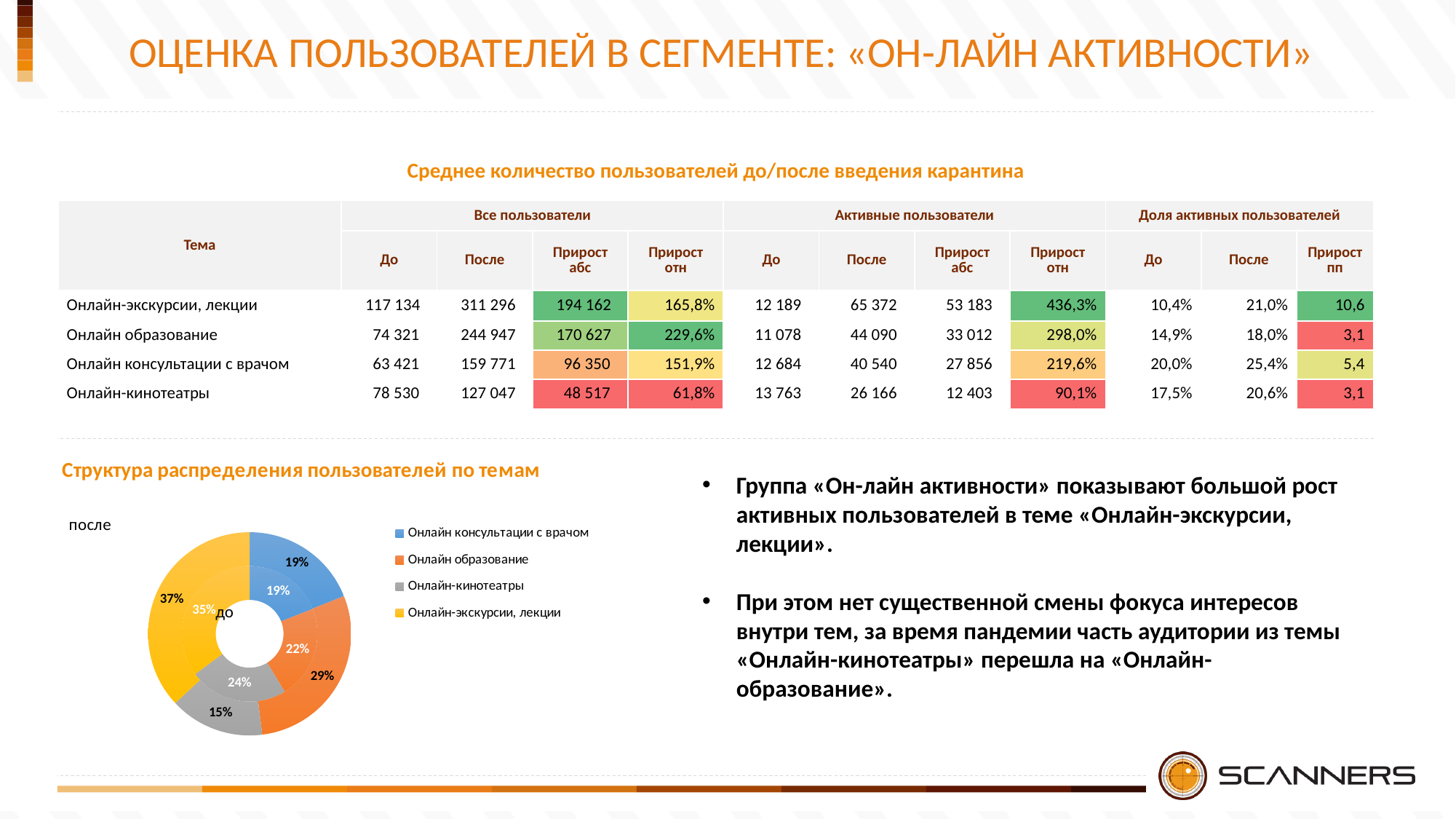
In the doughnut chart, what share does «Онлайн-кинотеатры» have in the outer ring («после»)? 15% In the doughnut chart, what share does «Онлайн-кинотеатры» have in the inner ring («до»)? 24% In the doughnut chart, what share does «Онлайн-экскурсии, лекции» have in the inner ring («до»)? 35% What kind of chart is shown under the heading «Структура распределения пользователей по темам»? Doughnut chart In the doughnut chart, which topic has the smallest share in the outer ring («после»)? Онлайн-кинотеатры In the doughnut chart, which colour represents «Онлайн консультации с врачом»? Blue How many topics does the legend of the doughnut chart list? 4 In the doughnut chart, by how many percentage points did the share of «Онлайн-кинотеатры» change from the inner ring («до») to the outer ring («после»)? 9 percentage points lower (24% to 15%) In the doughnut chart, which topic has the largest share in the outer ring («после»)? Онлайн-экскурсии, лекции